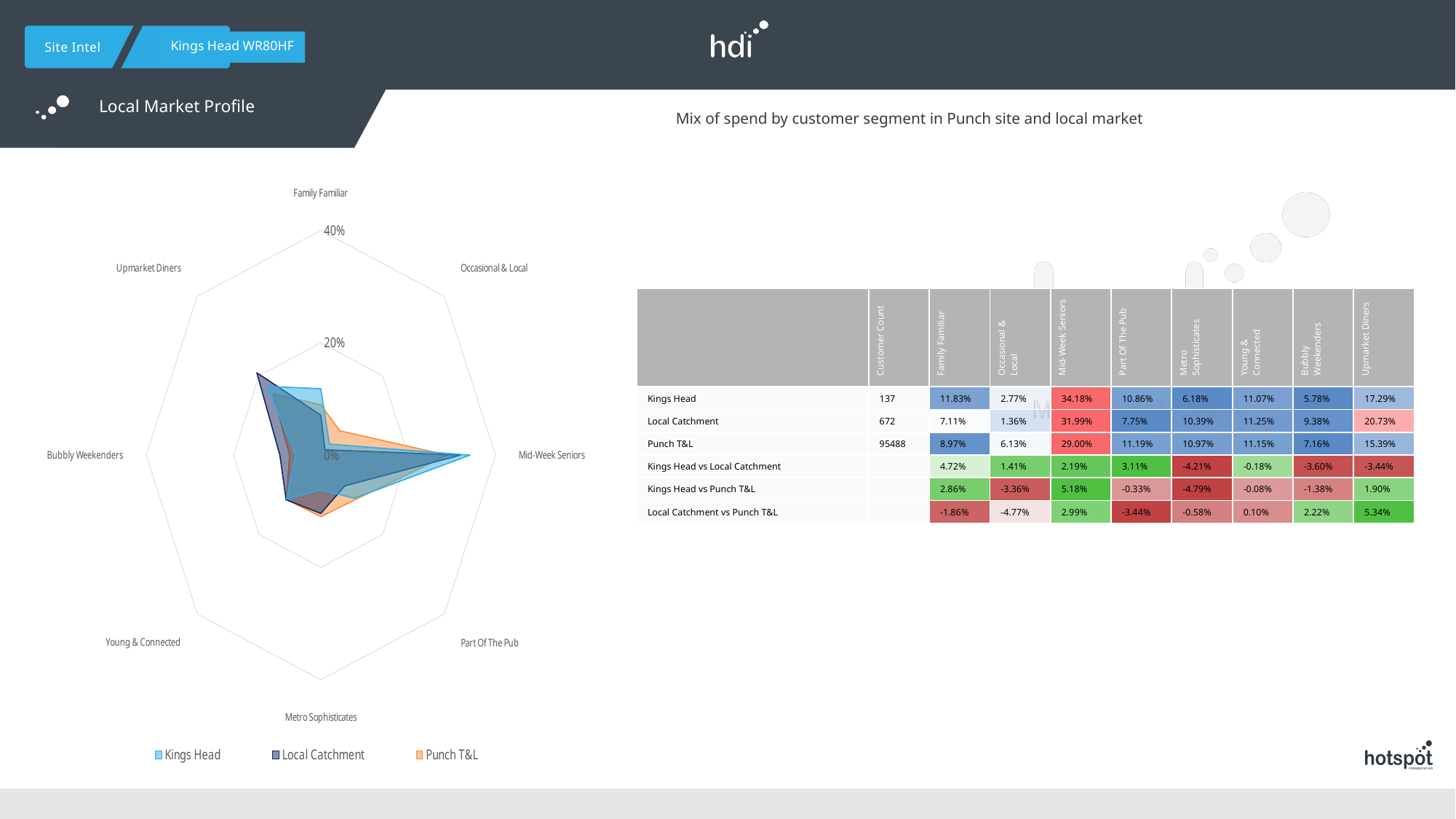
How many series does the legend of the radar chart list? 3 Is the Local Catchment value for Occasional & Local greater or less than 20%? less What is the difference between Kings Head and Local Catchment for Family Familiar? 4.72% What is the Punch T&L value for Metro Sophisticates? 10.97% For Upmarket Diners, which is larger: Kings Head or Local Catchment? Local Catchment Which customer segment has the lowest value for Kings Head? Occasional & Local Which customer segment has the highest value for Kings Head? Mid-Week Seniors How many customer segments are plotted around the radar chart? 8 What is the Kings Head value for Mid-Week Seniors? 34.18% Is the Kings Head value for Mid-Week Seniors greater or less than 20%? greater What is the highest percentage tick shown on the radar chart's axis? 40% What kind of chart is shown on the left of the slide? Radar chart